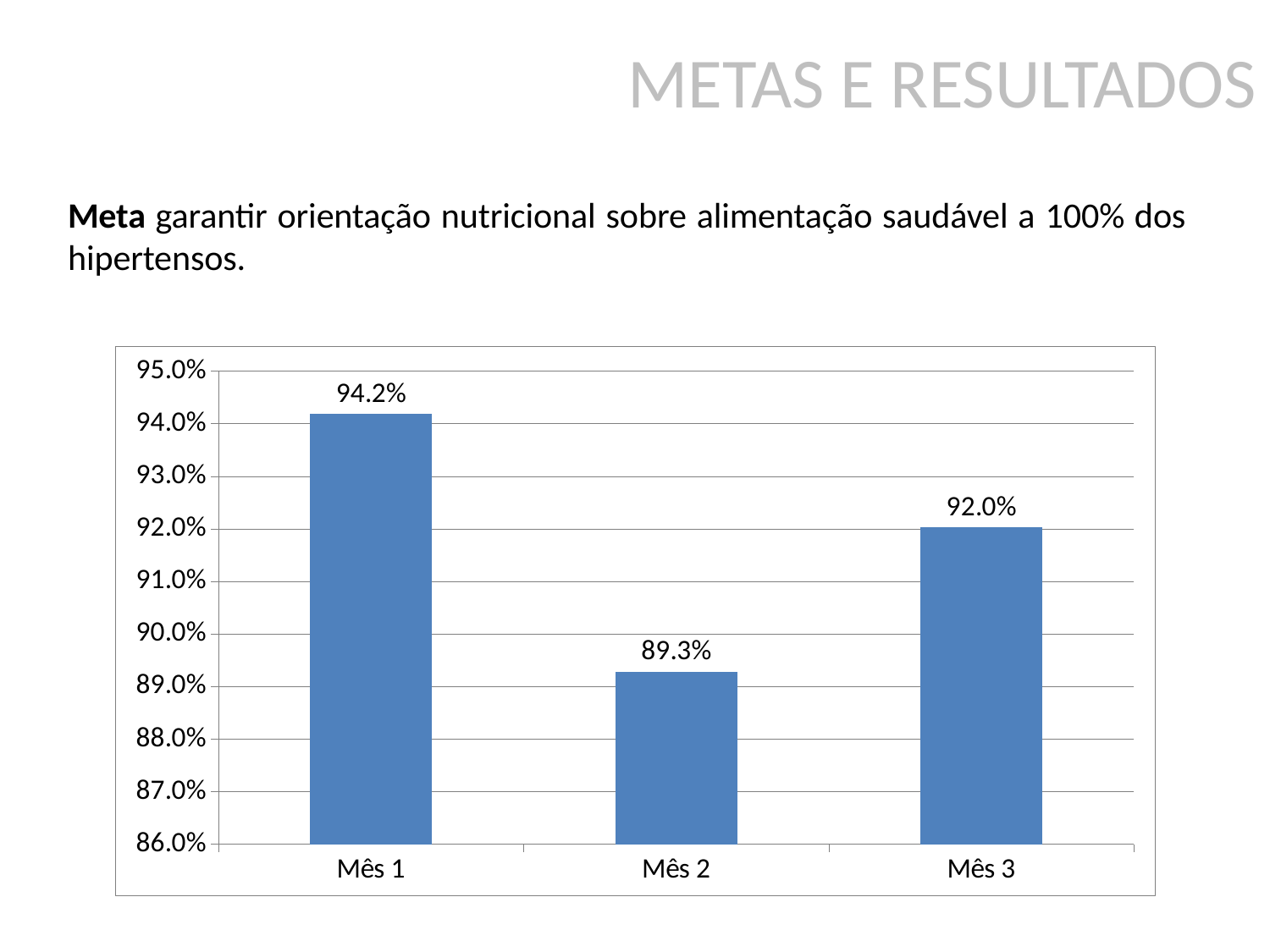
What is the value for Mês 3? 92.0% Does the value rise or fall from Mês 1 to Mês 2? fall Is the value for Mês 2 greater or less than 90.0%? less Which month has the lowest value? Mês 2 Which is larger, the value for Mês 2 or the value for Mês 3? Mês 3 What is the difference between the values for Mês 1 and Mês 3? 2.2% What is the value for Mês 1? 94.2% How many categories are shown on the x axis? 3 What kind of chart is shown on the slide? bar chart What is the value for Mês 2? 89.3% Which month has the highest value? Mês 1 What is the difference between the values for Mês 1 and Mês 2? 4.9%